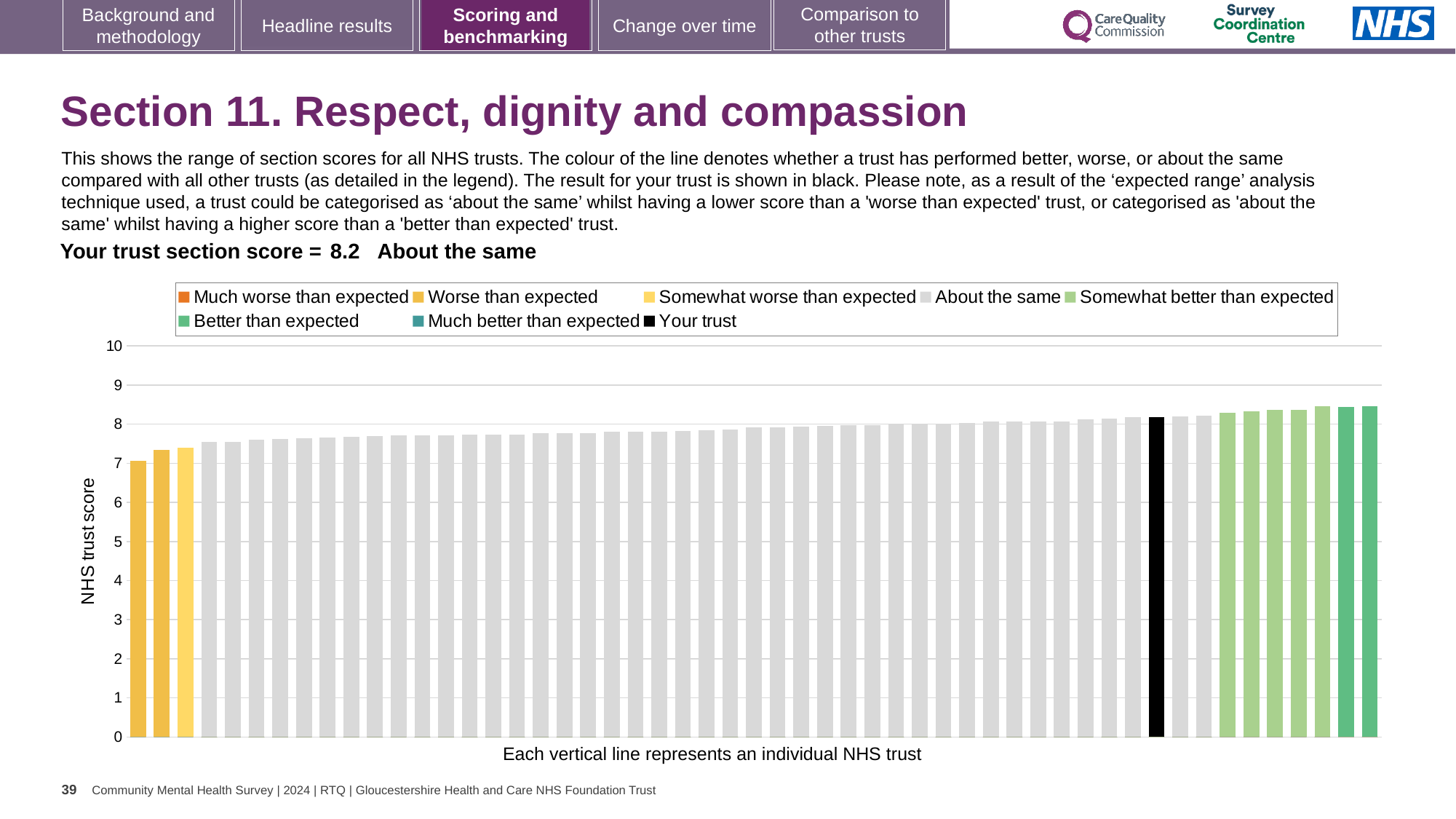
What is the section score for your trust shown on the slide? 8.2 Is the value of the leftmost (lowest) bar greater or less than 8? less What kind of chart is shown on the slide? bar chart Do the bar values rise or fall from left to right along the x axis? rise Is the value of the rightmost (highest) bar greater or less than 8? greater Which is larger: the value for your trust (black bar) or the value of the leftmost bar? your trust Which performance category is your trust placed in for this section? About the same Is the value for your trust (the black bar) greater or less than 8? greater How many bars are coloured as 'Much better than expected' (teal)? 0 What is the label on the vertical axis of the chart? NHS trust score How many entries does the chart legend list? 8